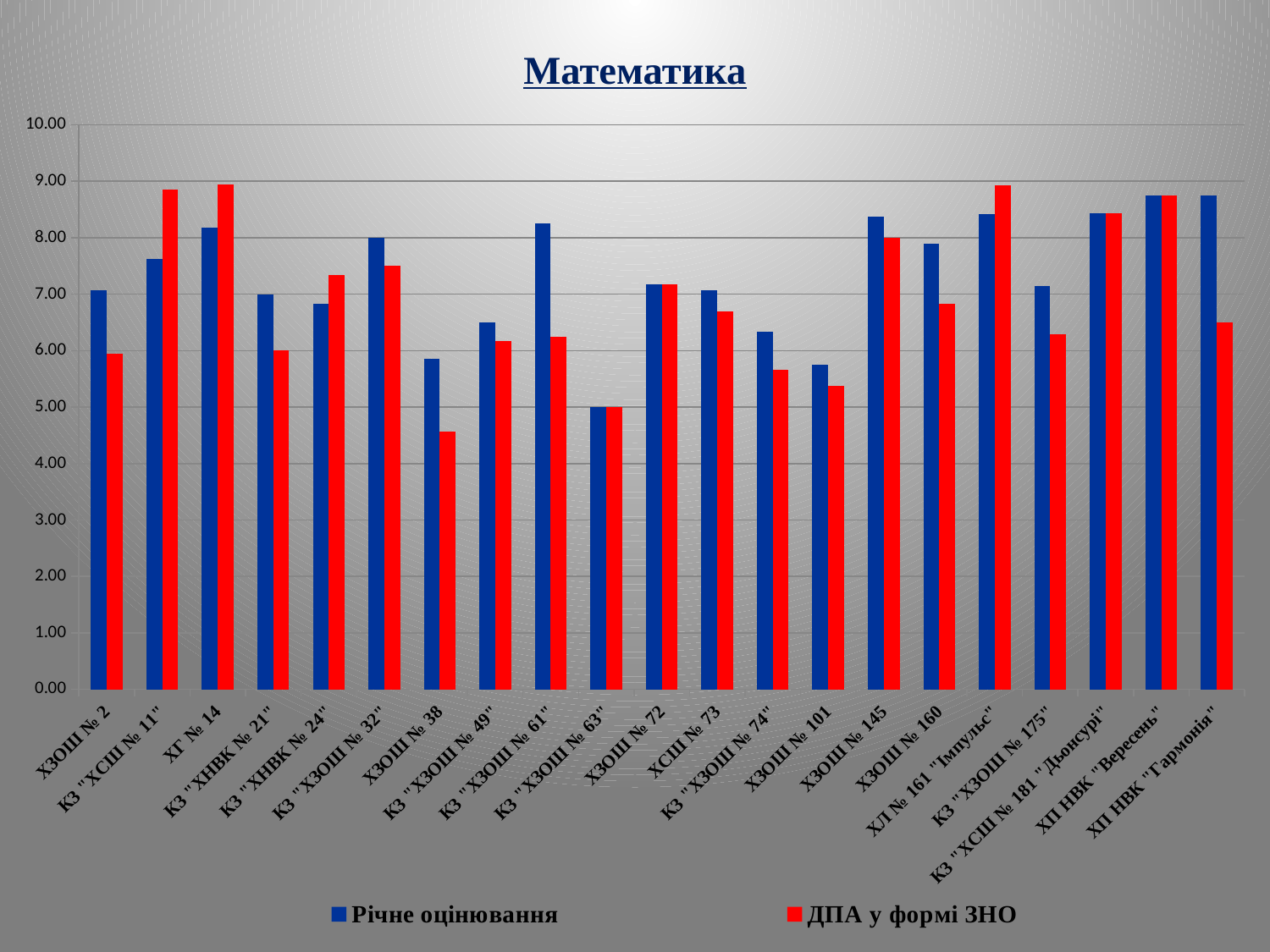
Which school has the lowest ДПА у формі ЗНО value? ХЗОШ № 38 Is the value of Річне оцінювання for КЗ "ХЗОШ № 61" greater or less than 8.00? greater For КЗ "ХСШ № 11", which is larger: Річне оцінювання or ДПА у формі ЗНО? ДПА у формі ЗНО Is the value of ДПА у формі ЗНО for КЗ "ХСШ № 11" greater or less than 8.00? greater How many schools (categories) are shown on the x axis? 21 Is the value of ДПА у формі ЗНО for ХЗОШ № 38 greater or less than 5.00? less For КЗ "ХЗОШ № 61", which is larger: Річне оцінювання or ДПА у формі ЗНО? Річне оцінювання What kind of chart is shown on the slide? bar chart Which series is shown in red? ДПА у формі ЗНО How many series does the legend list? 2 What is the title of the chart? Математика